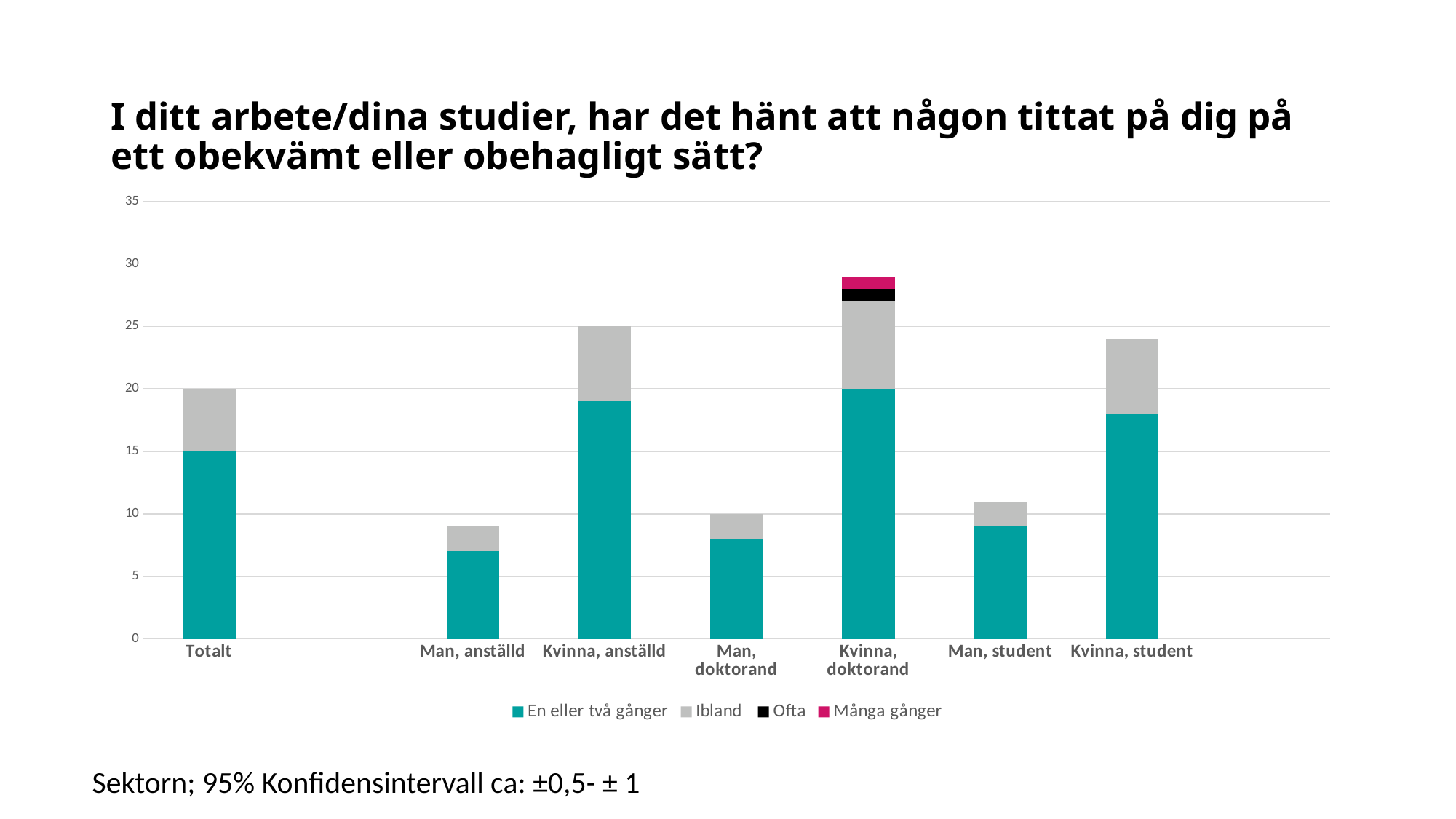
Is the total stacked value for Kvinna, anställd greater or less than 20? greater Is the total stacked value for Totalt greater or less than 15? greater Which has the larger total stacked bar, Kvinna, anställd or Man, anställd? Kvinna, anställd Is the 'En eller två gånger' value for Kvinna, doktorand greater or less than 15? greater How many categories are shown along the x axis of the chart? 7 Which series is shown in the pink/magenta colour in the legend? Många gånger How many series does the chart's legend list? 4 Which category has the highest total stacked bar? Kvinna, doktorand Which is the only category whose bar includes the 'Ofta' and 'Många gånger' segments? Kvinna, doktorand What kind of chart is shown on the slide? Stacked bar chart